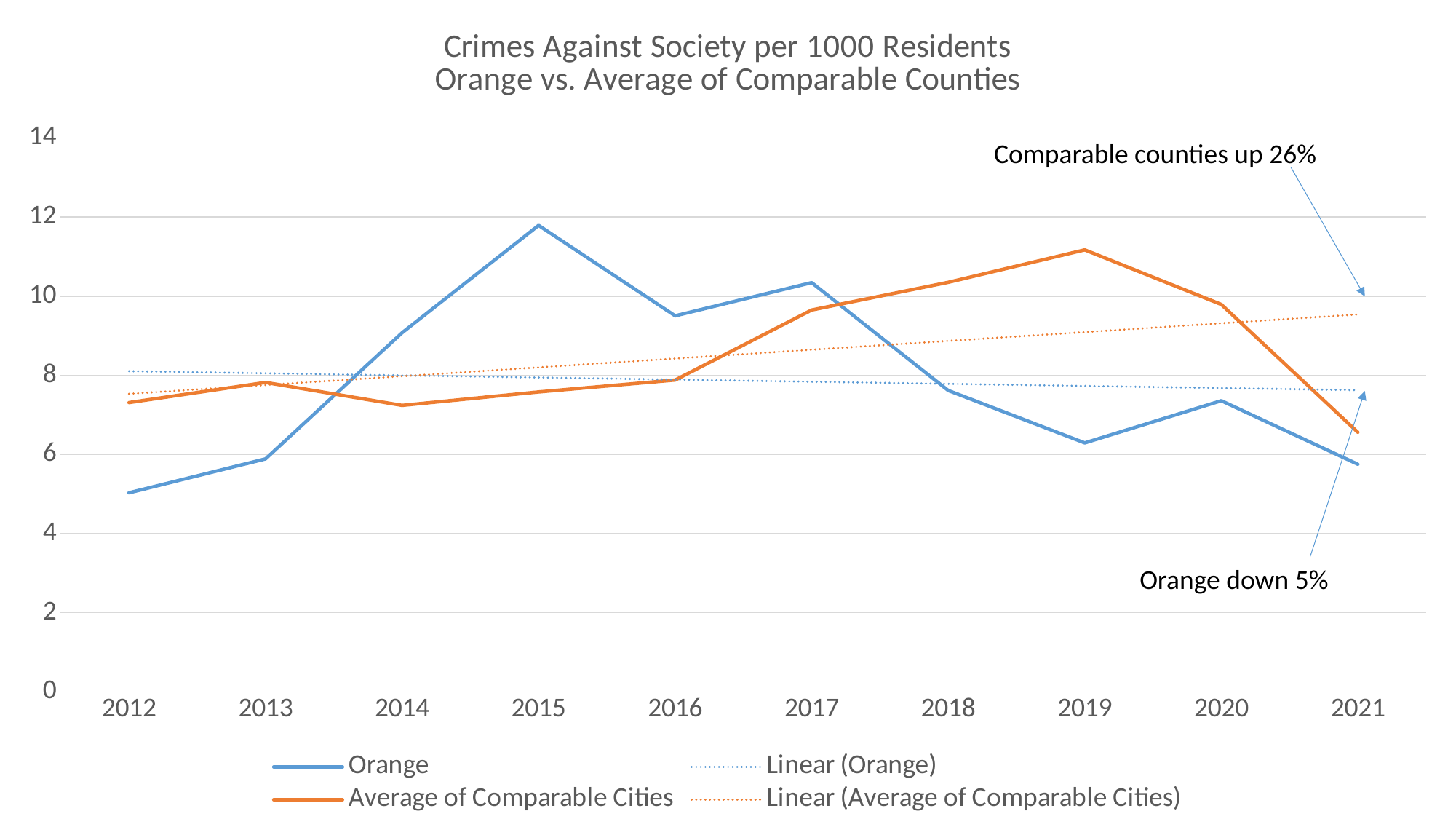
In which year does the Average of Comparable Cities series reach its highest value? 2019 Is the value for Orange in 2015 greater or less than 10? greater According to the annotation, by what percentage did comparable counties go up? 26% In 2015, which series has the higher value, Orange or Average of Comparable Cities? Orange Is the value for Average of Comparable Cities in 2014 greater or less than 8? less How many series does the legend list? 4 Is the value for Orange in 2021 greater or less than 6? less How many years are shown on the x axis? 10 In which year is the Orange series at its lowest value? 2012 In 2019, which series has the higher value, Orange or Average of Comparable Cities? Average of Comparable Cities What kind of chart is shown on the slide? line chart In which year does the Orange series reach its highest value? 2015